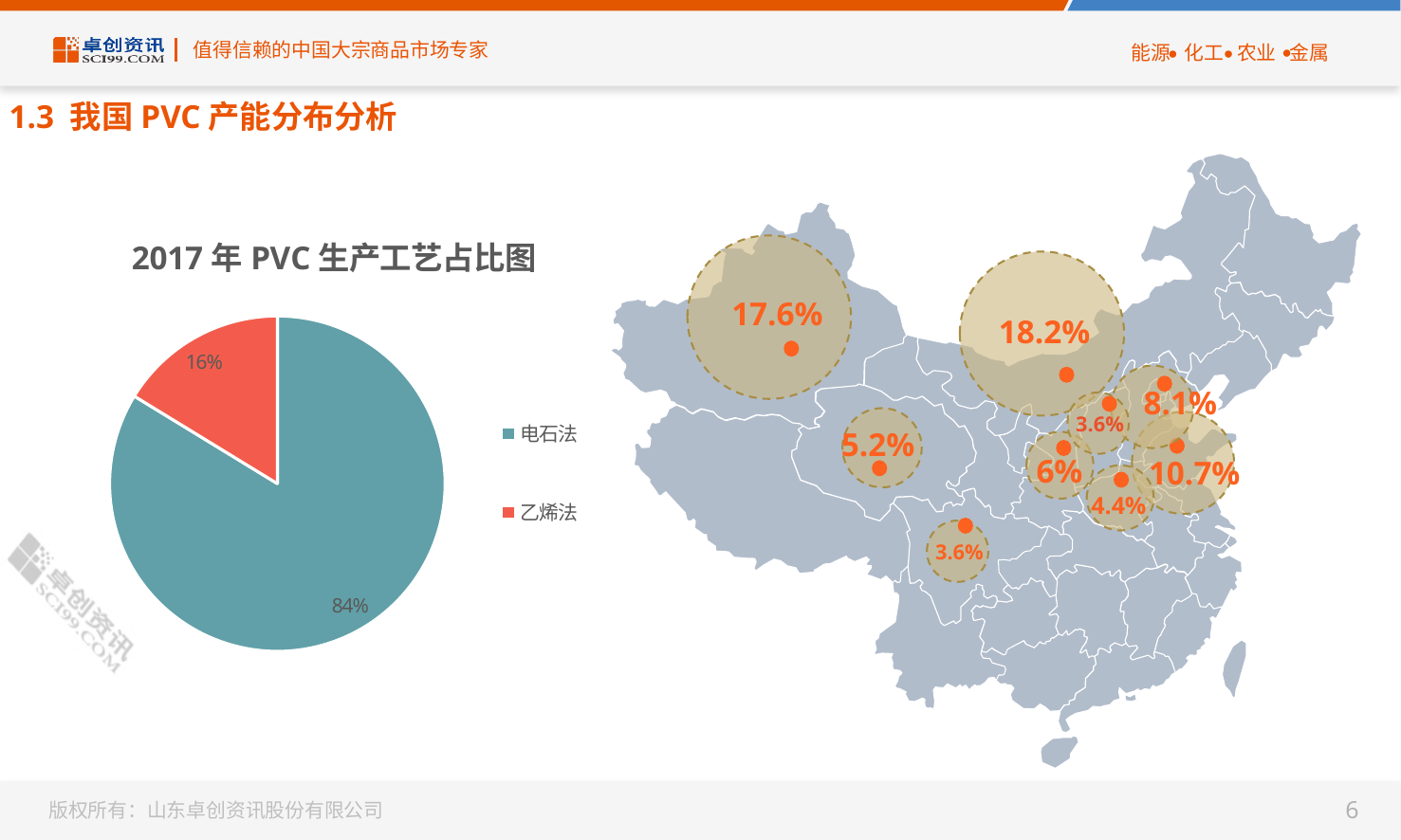
On the map chart on the right of the slide, what is the smallest percentage shown in any bubble? 3.6% How many entries does the legend of the pie chart "2017 年 PVC 生产工艺占比图" list? 2 In the pie chart "2017 年 PVC 生产工艺占比图", which process has the larger share? 电石法 What kind of chart is the "2017 年 PVC 生产工艺占比图" on the left of the slide? pie chart In the pie chart "2017 年 PVC 生产工艺占比图", what colour is the 乙烯法 slice? red How many slices does the pie chart "2017 年 PVC 生产工艺占比图" have? 2 In the pie chart "2017 年 PVC 生产工艺占比图", what share does 乙烯法 have? 16% On the map chart on the right of the slide, what is the largest percentage shown in any bubble? 18.2% In the pie chart "2017 年 PVC 生产工艺占比图", what share does 电石法 have? 84% In the pie chart "2017 年 PVC 生产工艺占比图", what is the difference in percentage points between 电石法 and 乙烯法? 68 In the pie chart "2017 年 PVC 生产工艺占比图", which process has the smaller share? 乙烯法 How many percentage bubbles are plotted on the map chart on the right of the slide? 9